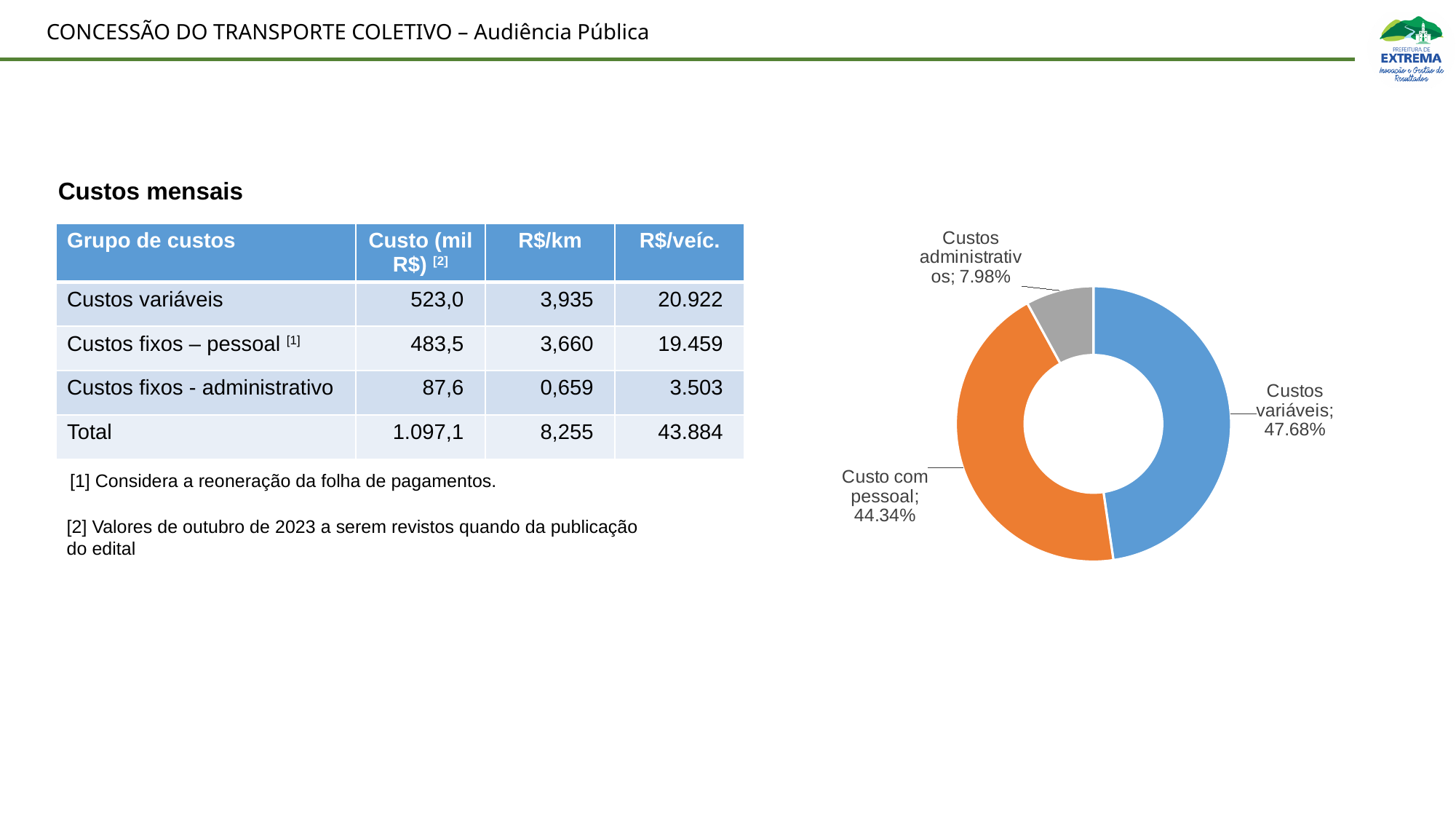
What colour is the Custo com pessoal slice in the doughnut chart? orange What is the difference in percentage points between the Custos variáveis slice and the Custo com pessoal slice? 3.34% How many slices does the doughnut chart have? 3 What share of the doughnut chart does the Custo com pessoal slice represent? 44.34% Which slice is larger in the doughnut chart, Custos variáveis or Custo com pessoal? Custos variáveis Which category has the largest slice in the doughnut chart? Custos variáveis What kind of chart is shown on the slide? doughnut chart Which category has the smallest slice in the doughnut chart? Custos administrativos What share of the doughnut chart does the Custos variáveis slice represent? 47.68% What share of the doughnut chart does the Custos administrativos slice represent? 7.98% What colour is the Custos administrativos slice in the doughnut chart? grey What is the difference in percentage points between the Custo com pessoal slice and the Custos administrativos slice? 36.36%